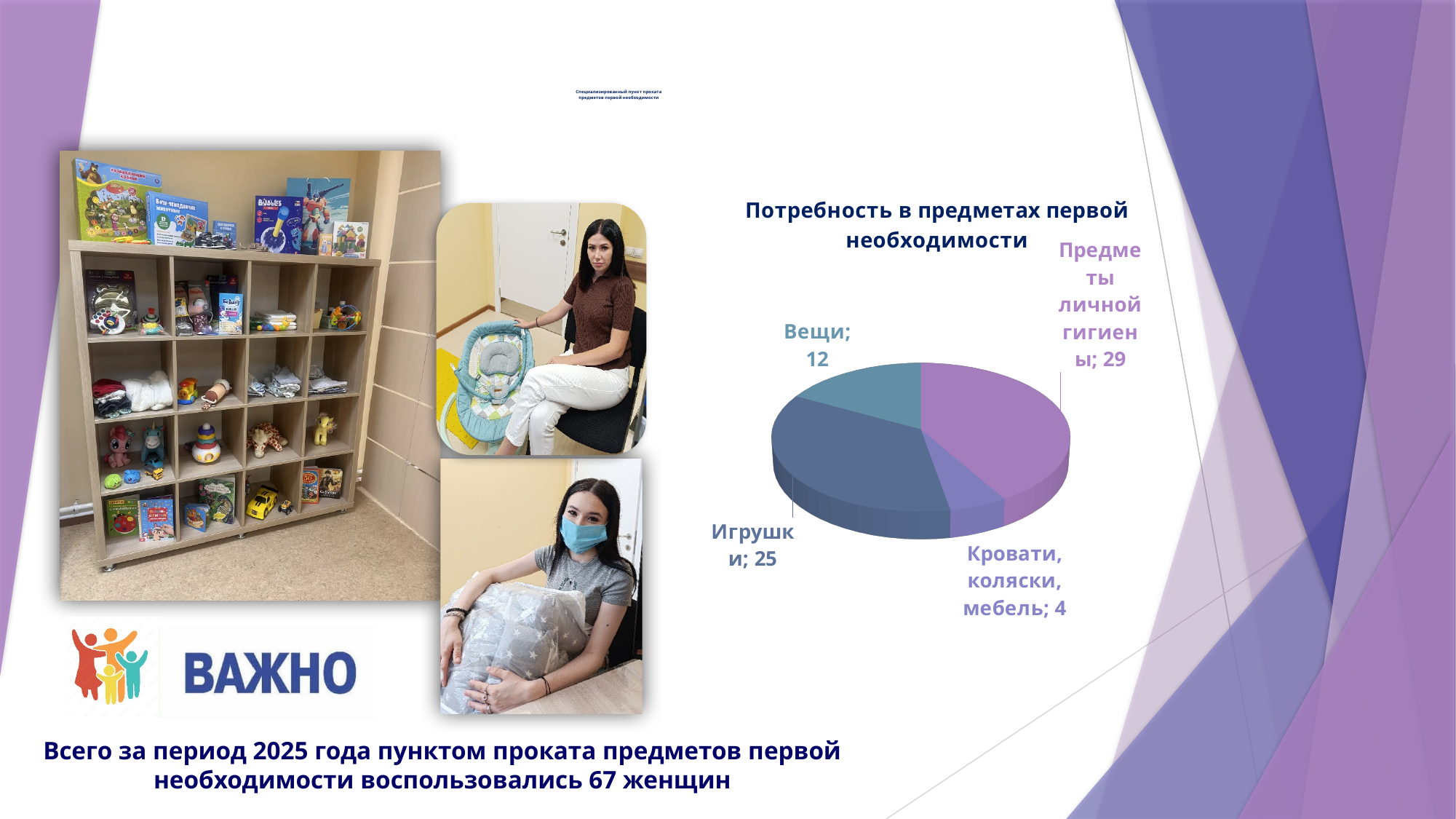
Which category has the largest slice in the pie chart? Предметы личной гигиены What type of chart is shown on the slide? Pie chart What is the value for Кровати, коляски, мебель in the pie chart? 4 How many categories are shown in the pie chart? 4 What is the title of the pie chart? Потребность в предметах первой необходимости What is the value for Предметы личной гигиены in the pie chart? 29 What is the value for Вещи in the pie chart? 12 What is the value for Игрушки in the pie chart? 25 Which category has the smallest slice in the pie chart? Кровати, коляски, мебель What is the difference between the values for Предметы личной гигиены and Игрушки? 4 Which is larger in the pie chart: Вещи or Игрушки? Игрушки What is the total of all values in the pie chart? 70